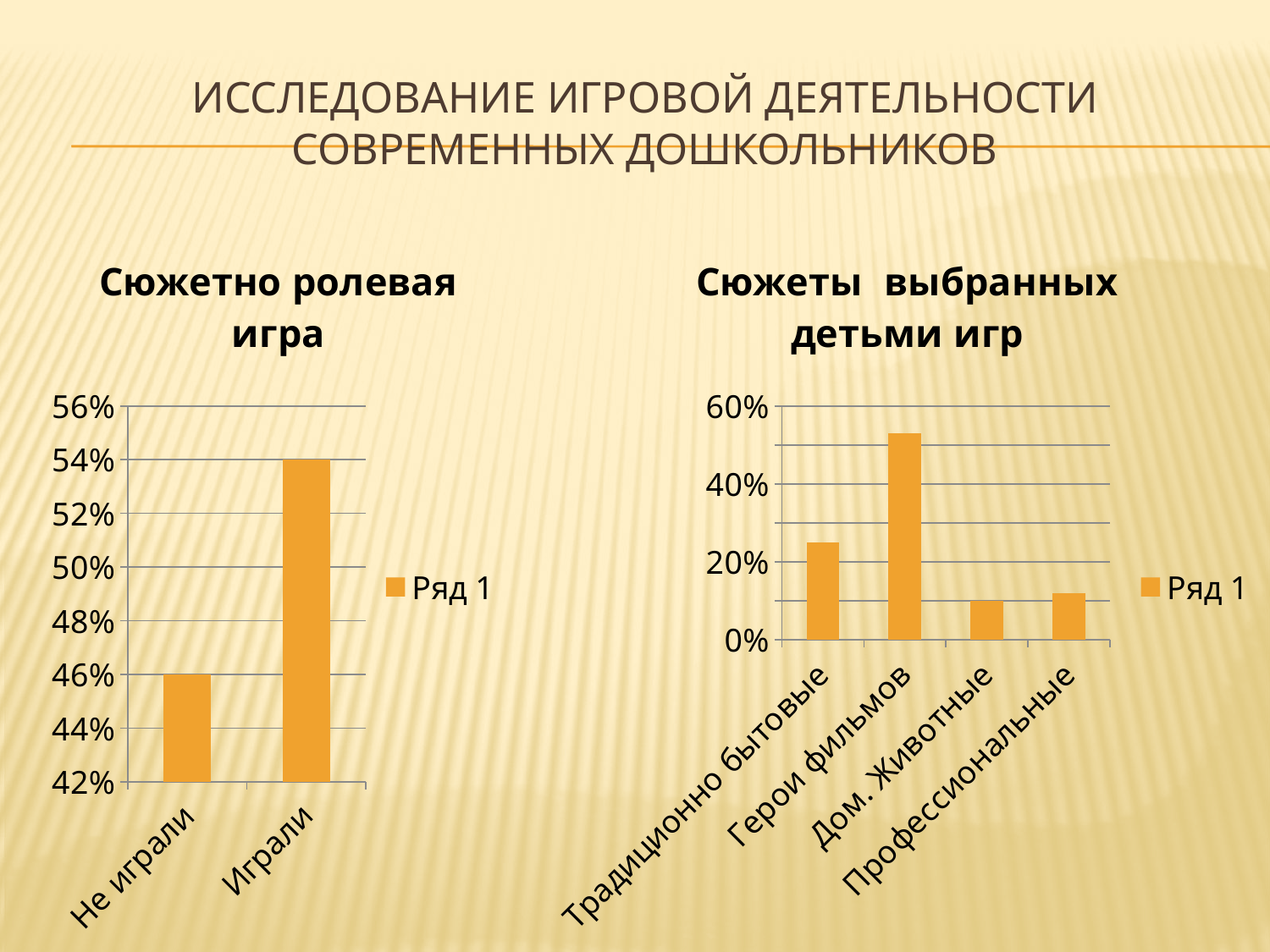
In the chart titled "Сюжеты выбранных детьми игр", which category has the highest value? Герои фильмов In the chart titled "Сюжеты выбранных детьми игр", is the value for "Герои фильмов" greater or less than 40%? greater In the chart titled "Сюжетно ролевая игра", how many categories are shown on the x axis? 2 In the chart titled "Сюжетно ролевая игра", which category has the higher value? Играли In the chart titled "Сюжеты выбранных детьми игр", which is larger: the value for "Традиционно бытовые" or the value for "Профессиональные"? Традиционно бытовые What kind of chart is the chart titled "Сюжеты выбранных детьми игр"? bar chart In the chart titled "Сюжетно ролевая игра", what is the value for "Играли"? 54% In the chart titled "Сюжетно ролевая игра", what is the difference between the values for "Играли" and "Не играли"? 8% In the chart titled "Сюжеты выбранных детьми игр", is the value for "Традиционно бытовые" greater or less than 40%? less In the chart titled "Сюжеты выбранных детьми игр", how many categories are shown on the x axis? 4 In the chart titled "Сюжетно ролевая игра", what is the value for "Не играли"? 46% In the chart titled "Сюжеты выбранных детьми игр", is the value for "Дом. Животные" greater or less than 20%? less